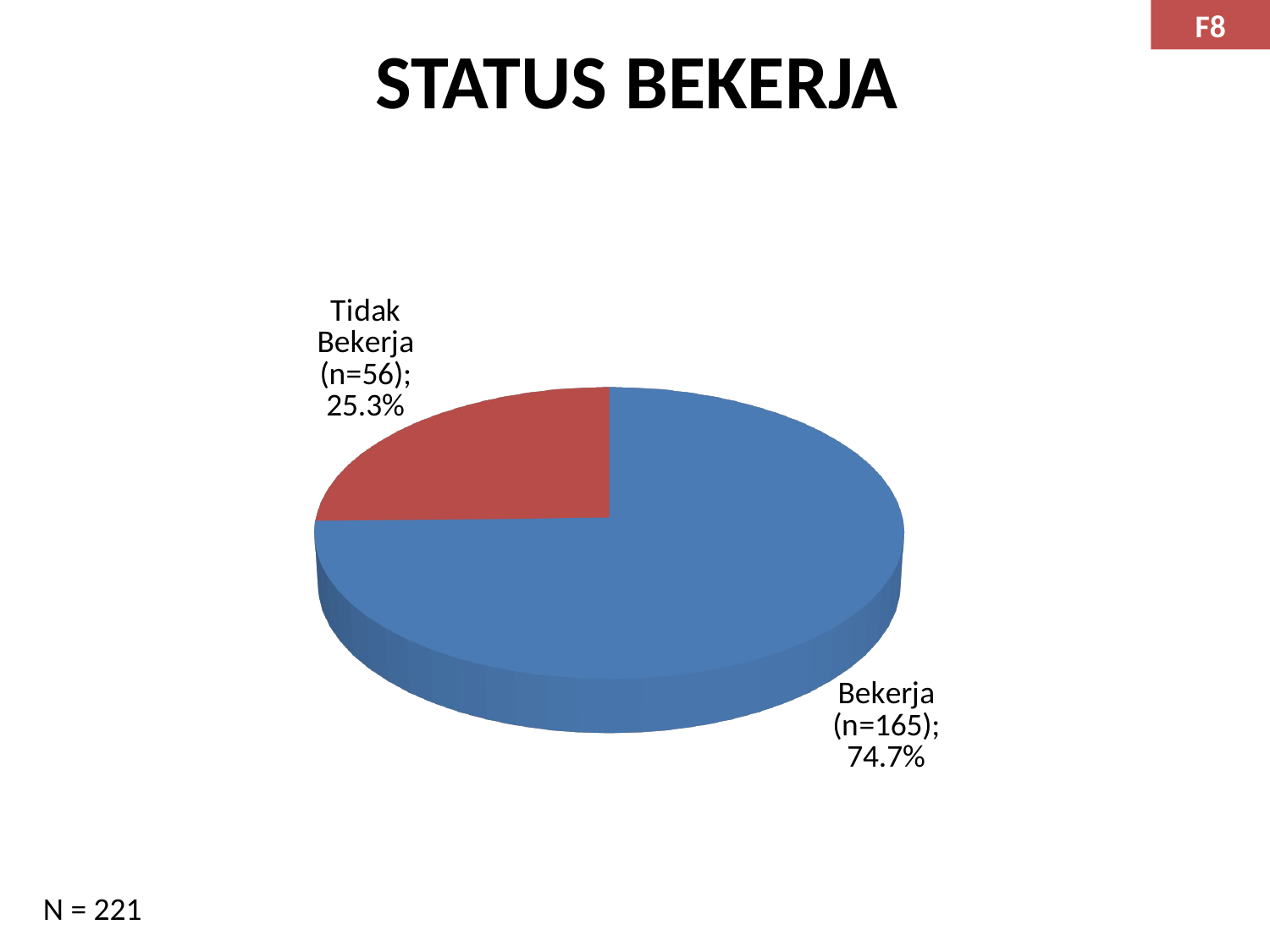
What is the difference in percentage points between the Bekerja and Tidak Bekerja slices? 49.4 Which category has the largest slice of the pie? Bekerja What is the title of the chart? STATUS BEKERJA Which category has the smallest slice of the pie? Tidak Bekerja What colour is the Tidak Bekerja slice? red How many respondents are in the Tidak Bekerja category? 56 What kind of chart is shown on the slide? pie chart How many slices does the pie chart have? 2 Which is larger, the Bekerja slice or the Tidak Bekerja slice? Bekerja How many respondents are in the Bekerja category? 165 What percentage of the pie is the Bekerja slice? 74.7% What percentage of the pie is the Tidak Bekerja slice? 25.3%